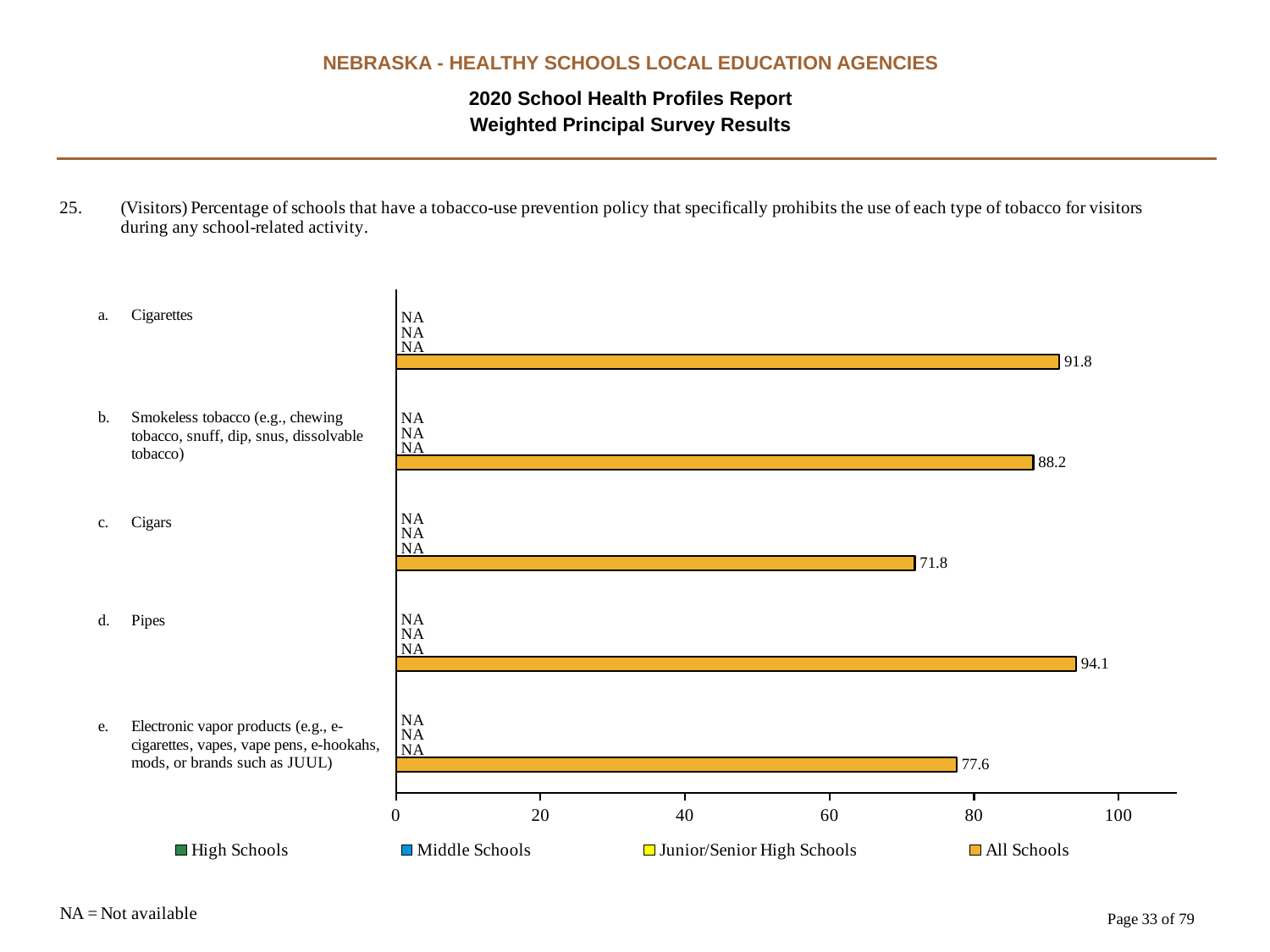
Is the All Schools value for Cigars greater or less than 80? less What is the All Schools value for Pipes? 94.1 Which tobacco type has the lowest All Schools value? Cigars What kind of chart is shown on the slide? bar chart What value is shown for High Schools for Smokeless tobacco? NA How many series does the legend list? 4 Which has a larger All Schools value, Cigarettes or Smokeless tobacco? Cigarettes How many tobacco types are listed on the chart? 5 Which tobacco type has the highest All Schools value? Pipes What is the All Schools value for Cigarettes? 91.8 What is the All Schools value for Electronic vapor products? 77.6 What is the difference between the All Schools values for Pipes and Cigars? 22.3